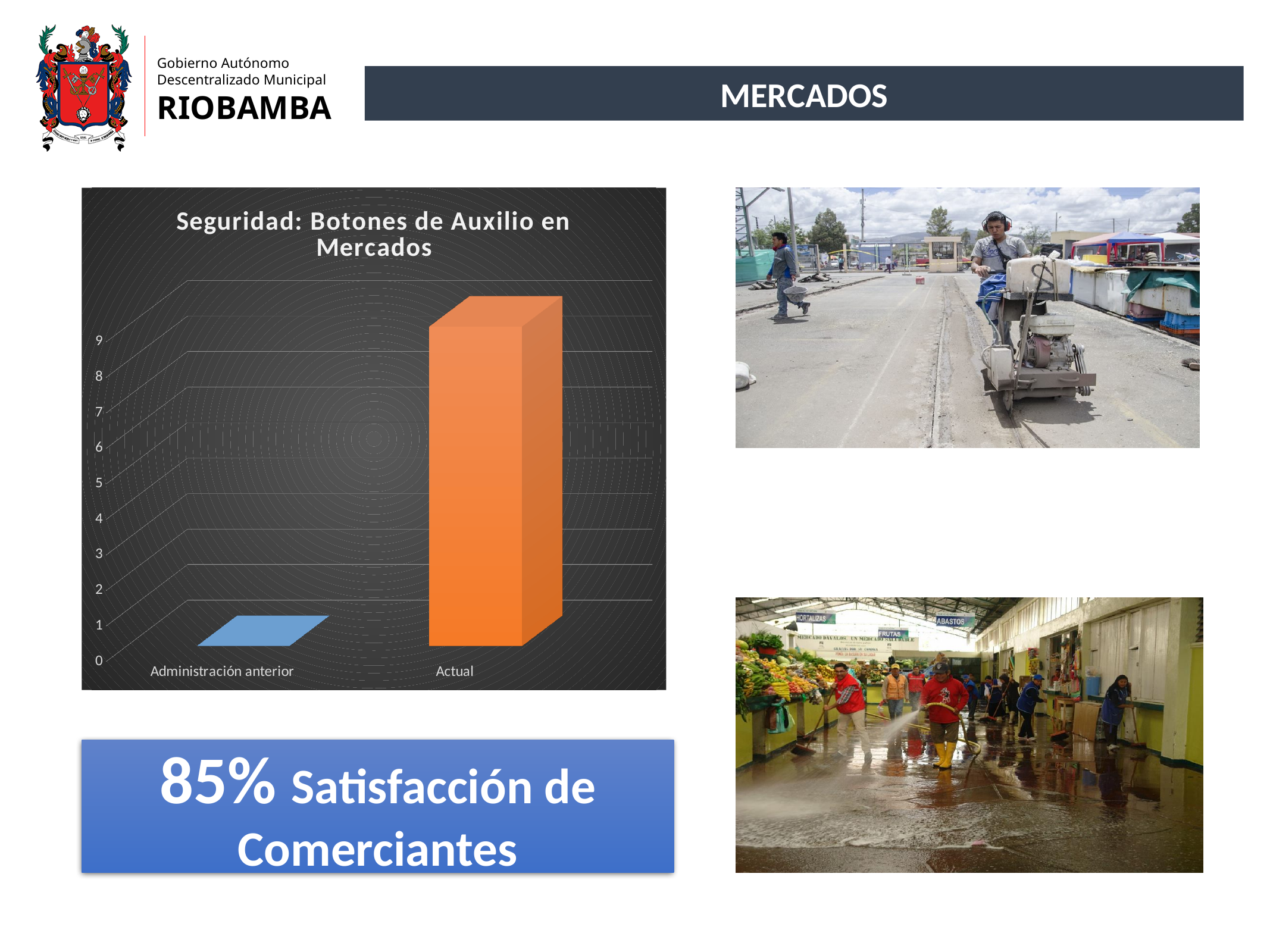
How many categories are shown on the x axis of the chart? 2 What kind of chart is shown on the slide? bar chart Is the value for Administración anterior greater or less than 1? less Is the value for Actual greater or less than 5? greater Which category has the lowest value in the chart? Administración anterior Which category has the highest value in the chart? Actual What is the title of the chart? Seguridad: Botones de Auxilio en Mercados What colour is the bar for Actual? orange Which is larger, the value for Administración anterior or the value for Actual? Actual What is the highest tick value shown on the vertical axis of the chart? 9 Do the values rise or fall from Administración anterior to Actual? rise What is the value for Administración anterior in the chart? 0